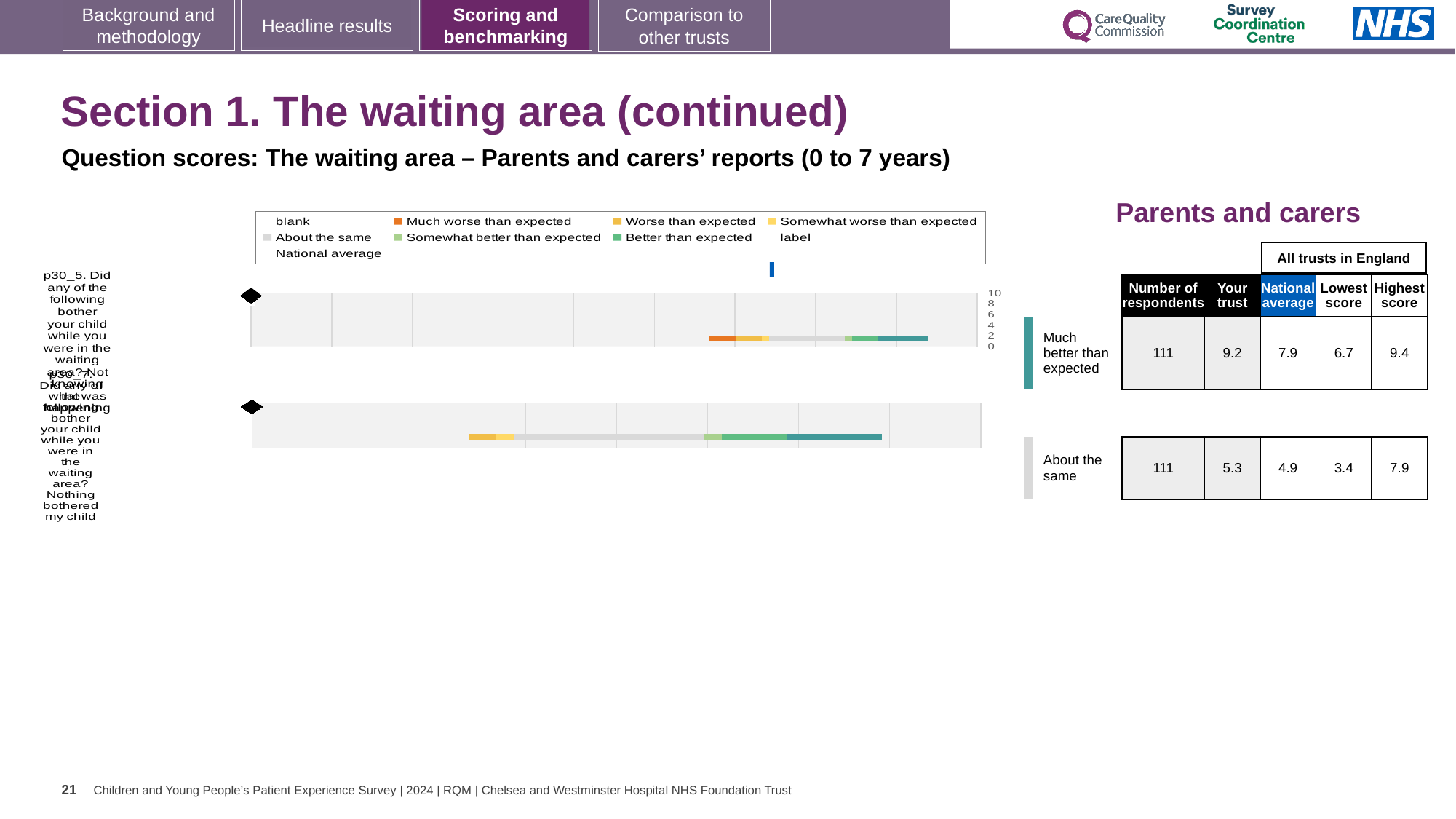
In the table, what is the difference between the 'Your trust' score and the national average for the 'Much better than expected' row? 1.3 In the table, what is the highest score across all trusts in England for the 'About the same' row? 7.9 In the table, what is the 'Your trust' score for the row labelled 'Much better than expected'? 9.2 How many entries does the chart legend list? 9 In the table, what is the national average for the row labelled 'About the same'? 4.9 In the table, what is the lowest score across all trusts in England for the 'Much better than expected' row? 6.7 In the table, what is the number of respondents for the 'Much better than expected' row? 111 Which row has the higher 'Your trust' score in the table: 'Much better than expected' or 'About the same'? Much better than expected What kind of chart is shown on the slide? Bar chart What colour represents 'Much worse than expected' in the chart legend? Orange How many question bars are plotted in the chart? 2 What is the highest tick value shown on the chart's axis? 10